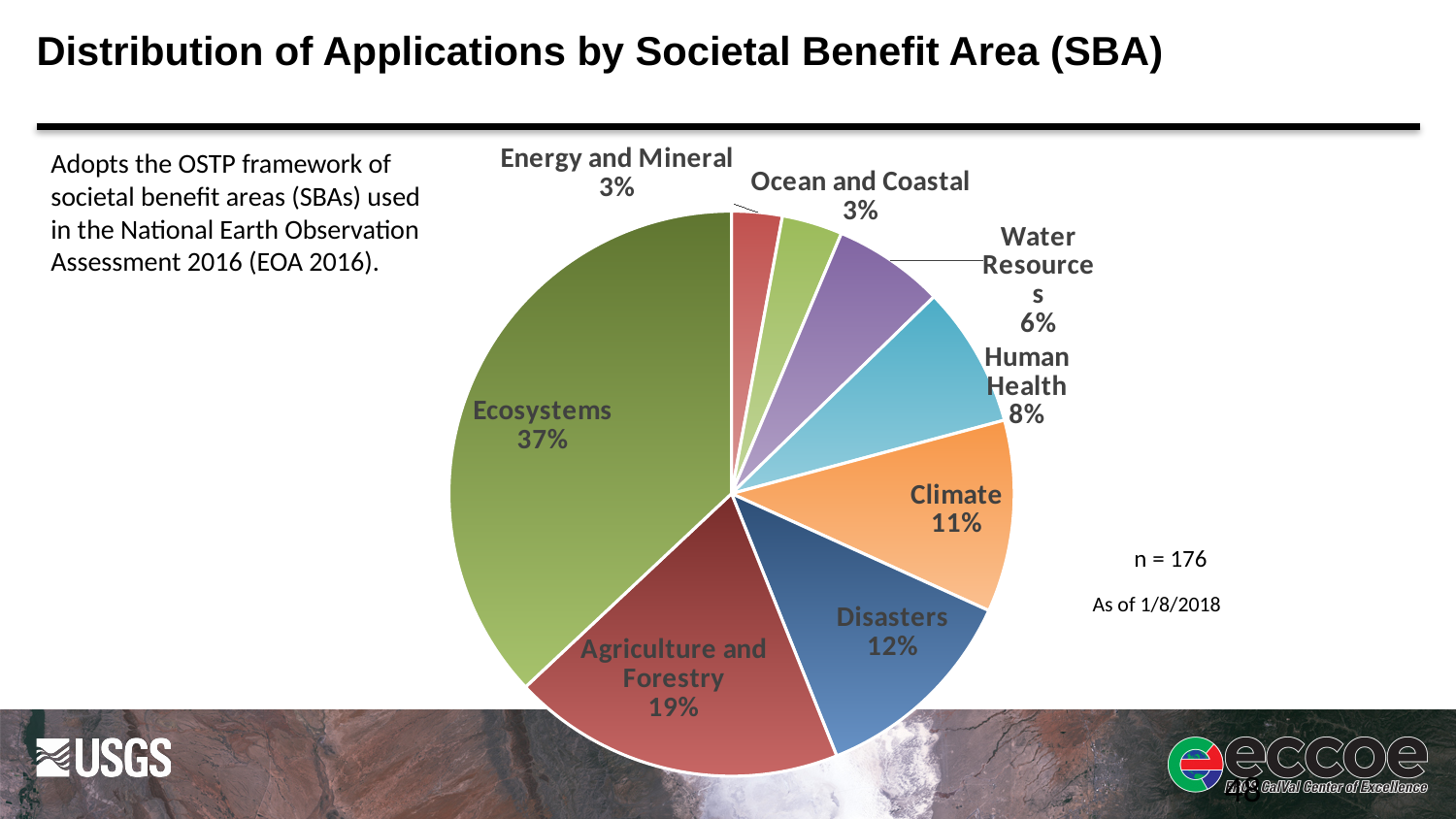
What is the title of the chart on the slide? Distribution of Applications by Societal Benefit Area (SBA) What kind of chart is shown on the slide? pie chart What is the difference in percentage points between Disasters and Climate? 1 What percentage of applications is in the Disasters category? 12% How many societal benefit areas are shown in the pie chart? 8 What share of applications falls under Ecosystems? 37% Which societal benefit area has the largest share of applications? Ecosystems What is the difference in percentage points between Ecosystems and Agriculture and Forestry? 18 What percentage is shown for Human Health? 8% What is the value of n stated next to the chart? n = 176 Which category has a larger share, Climate or Water Resources? Climate What percentage is shown for Agriculture and Forestry? 19%